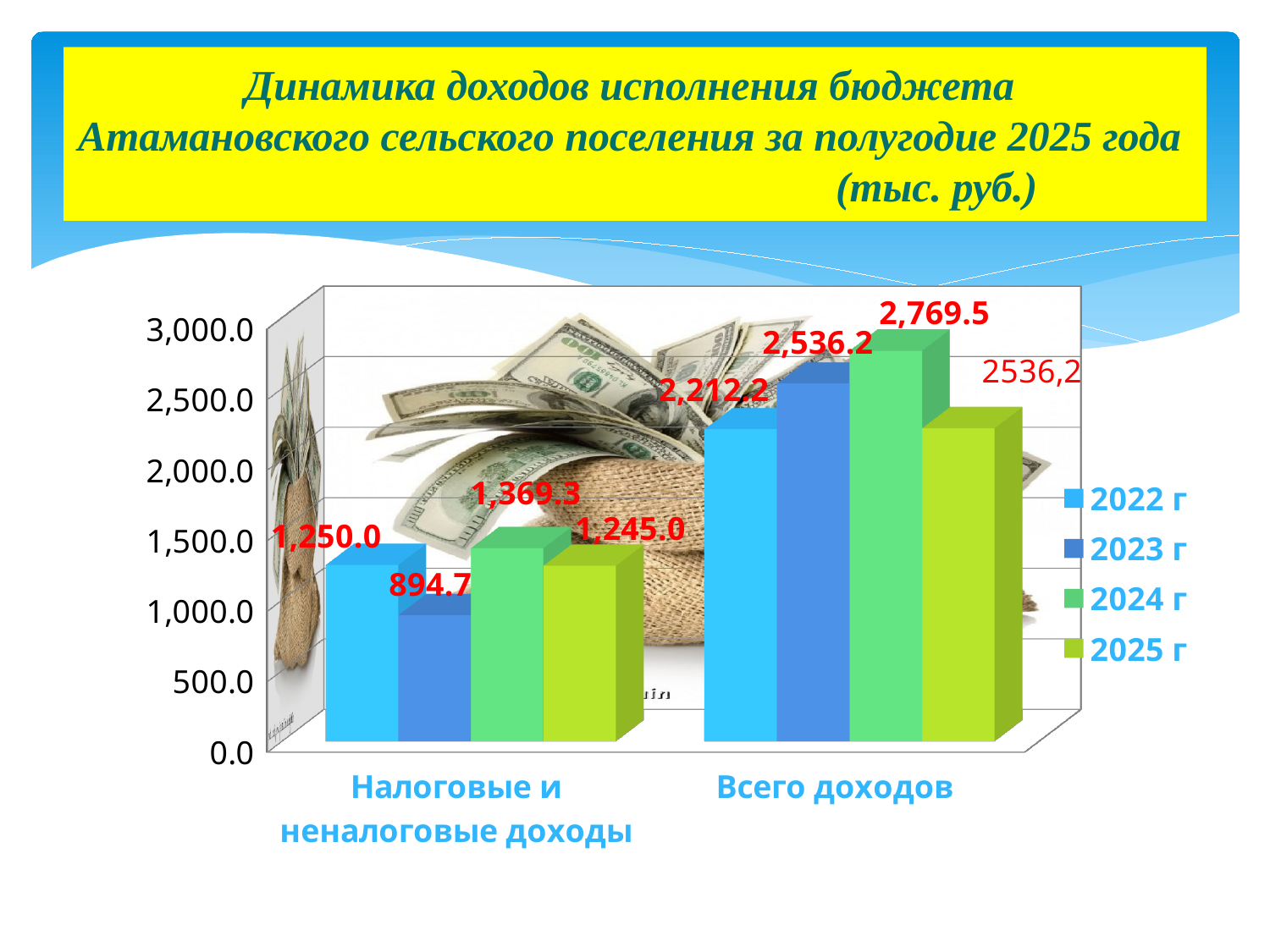
What kind of chart is shown on the slide? bar chart Is the value for 2023 г in the category Налоговые и неналоговые доходы greater or less than 1,000.0? less What is the value for 2023 г in the category Налоговые и неналоговые доходы? 894.7 What is the value for 2023 г in the category Всего доходов? 2,536.2 What is the difference between the 2024 г and 2023 г values in the category Налоговые и неналоговые доходы? 474.6 How many categories are shown on the x axis? 2 In the category Всего доходов, which is larger: the value for 2022 г or for 2023 г? 2023 г What is the value for 2022 г in the category Налоговые и неналоговые доходы? 1,250.0 How many series does the legend list? 4 Which year has the highest value in the category Налоговые и неналоговые доходы? 2024 г What is the value for 2024 г in the category Всего доходов? 2,769.5 Which year has the lowest value in the category Налоговые и неналоговые доходы? 2023 г